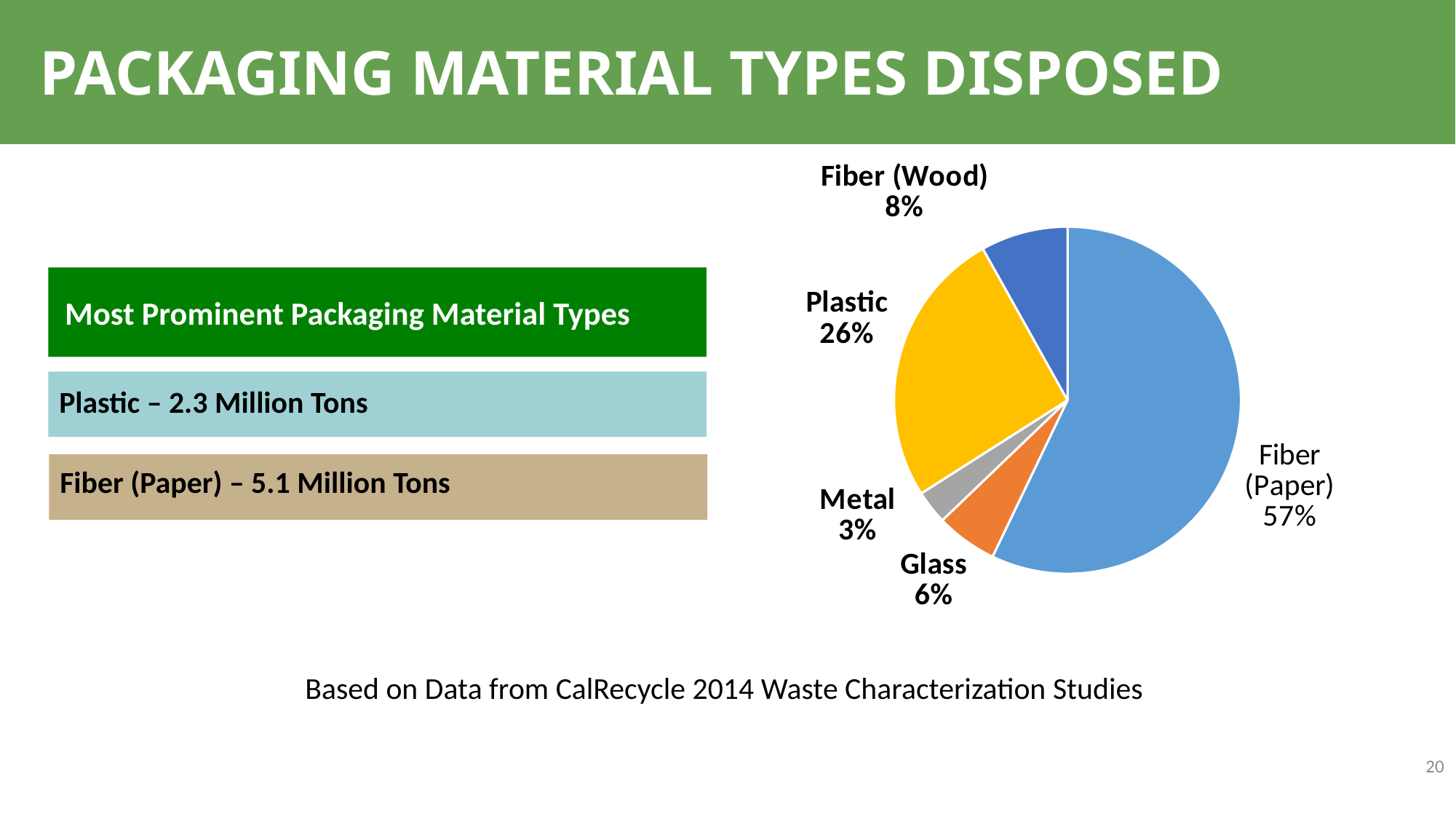
What share of the pie does Plastic represent? 26% What is the difference in percentage points between Fiber (Paper) and Plastic? 31 Which is larger, the Glass slice or the Fiber (Wood) slice? Fiber (Wood) Which category has the largest slice of the pie? Fiber (Paper) How many categories are shown in the pie chart? 5 What is the value shown for Metal? 3% What share of the pie does Fiber (Paper) represent? 57% What is the value shown for Fiber (Wood)? 8% What kind of chart is shown on the slide? Pie chart What is the value shown for Glass? 6% Which category has the smallest slice of the pie? Metal What colour is the Plastic slice of the pie? Yellow